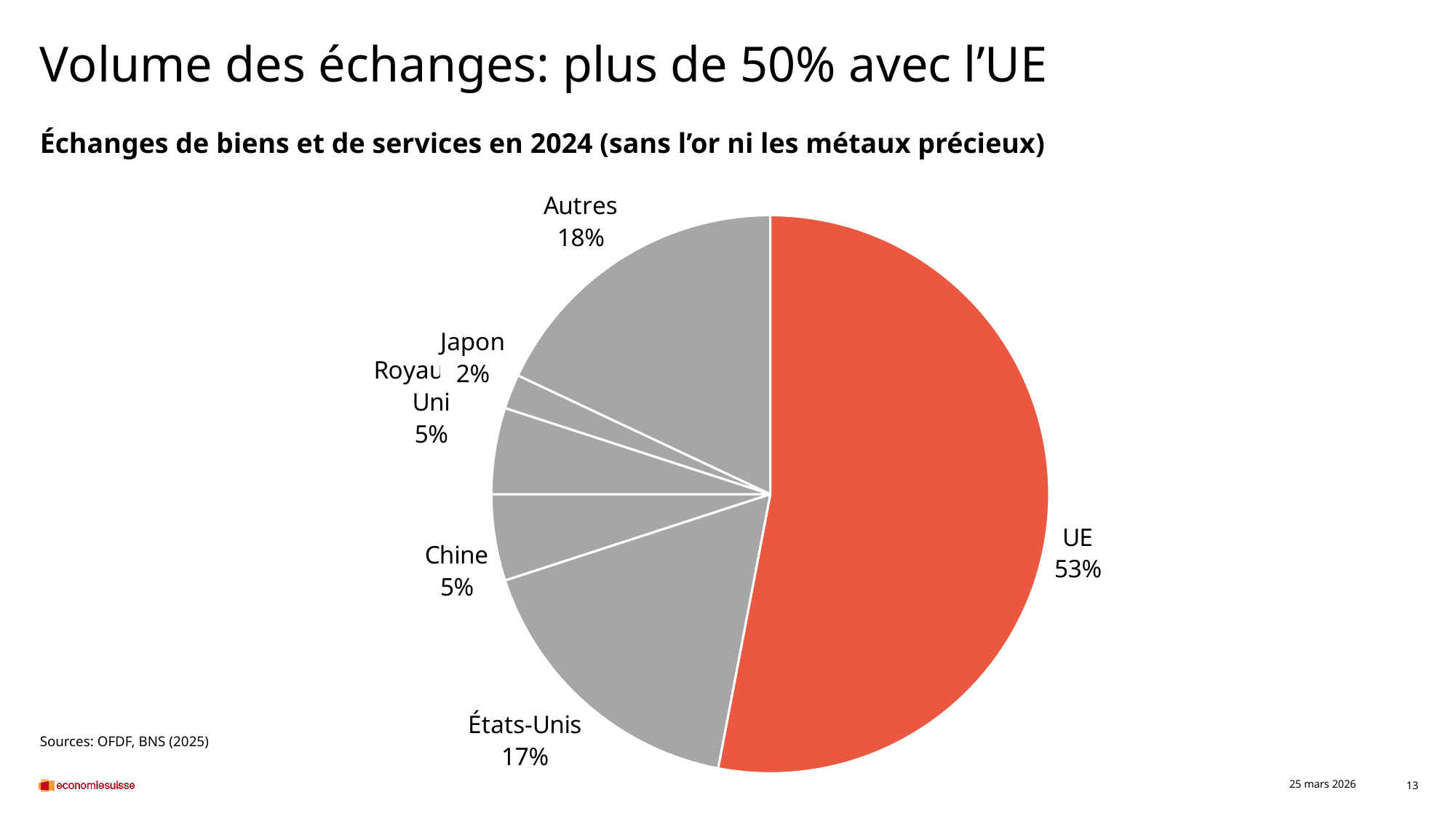
What kind of chart is shown on the slide? Pie chart What share of the pie does Autres hold? 18% What is the title of the chart? Échanges de biens et de services en 2024 (sans l'or ni les métaux précieux) What share of the pie does États-Unis hold? 17% Which category has the largest slice of the pie? UE Which category has the smallest slice of the pie? Japon Which slice is larger, Autres or États-Unis? Autres How many slices does the pie chart have? 6 What is the difference in percentage points between the UE slice and the États-Unis slice? 36 What share of the pie does Japon hold? 2% What share of the pie does UE hold? 53% What share of the pie does Chine hold? 5%